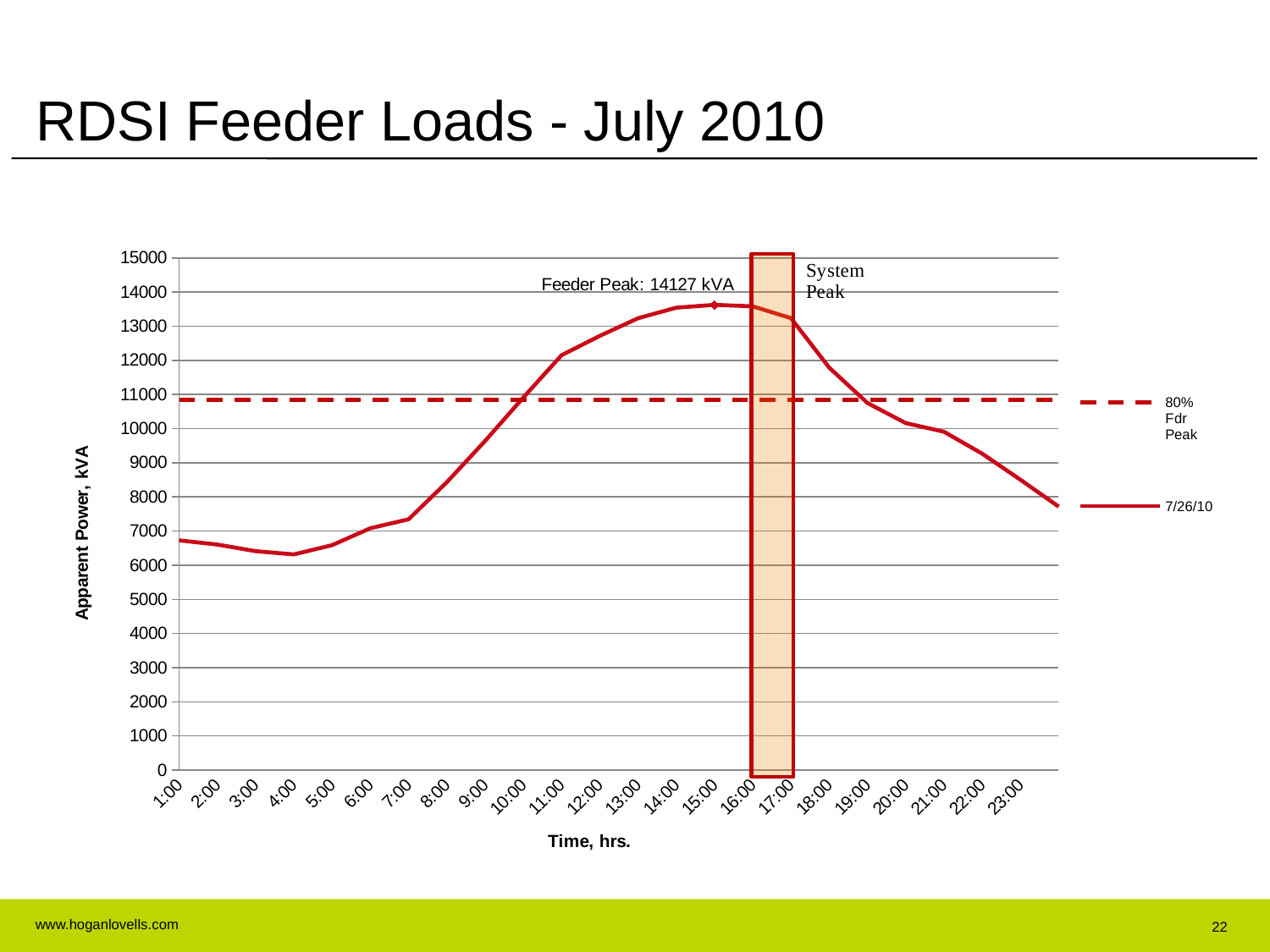
Is the value for 4:00 greater or less than 7000? less How many time points are labelled on the x axis? 23 Is the value for 9:00 greater or less than 10000? less At which time does the 7/26/10 line reach its lowest value? 4:00 At which time does the 7/26/10 line reach its highest value? 15:00 What feeder peak value is annotated on the chart? 14127 kVA Is the value for 20:00 greater or less than 11000? less Which has the larger value, 1:00 or 15:00? 15:00 How many entries does the chart legend list? 2 What kind of chart is shown on the slide? line chart Does the 7/26/10 line rise or fall between 15:00 and 23:00? fall